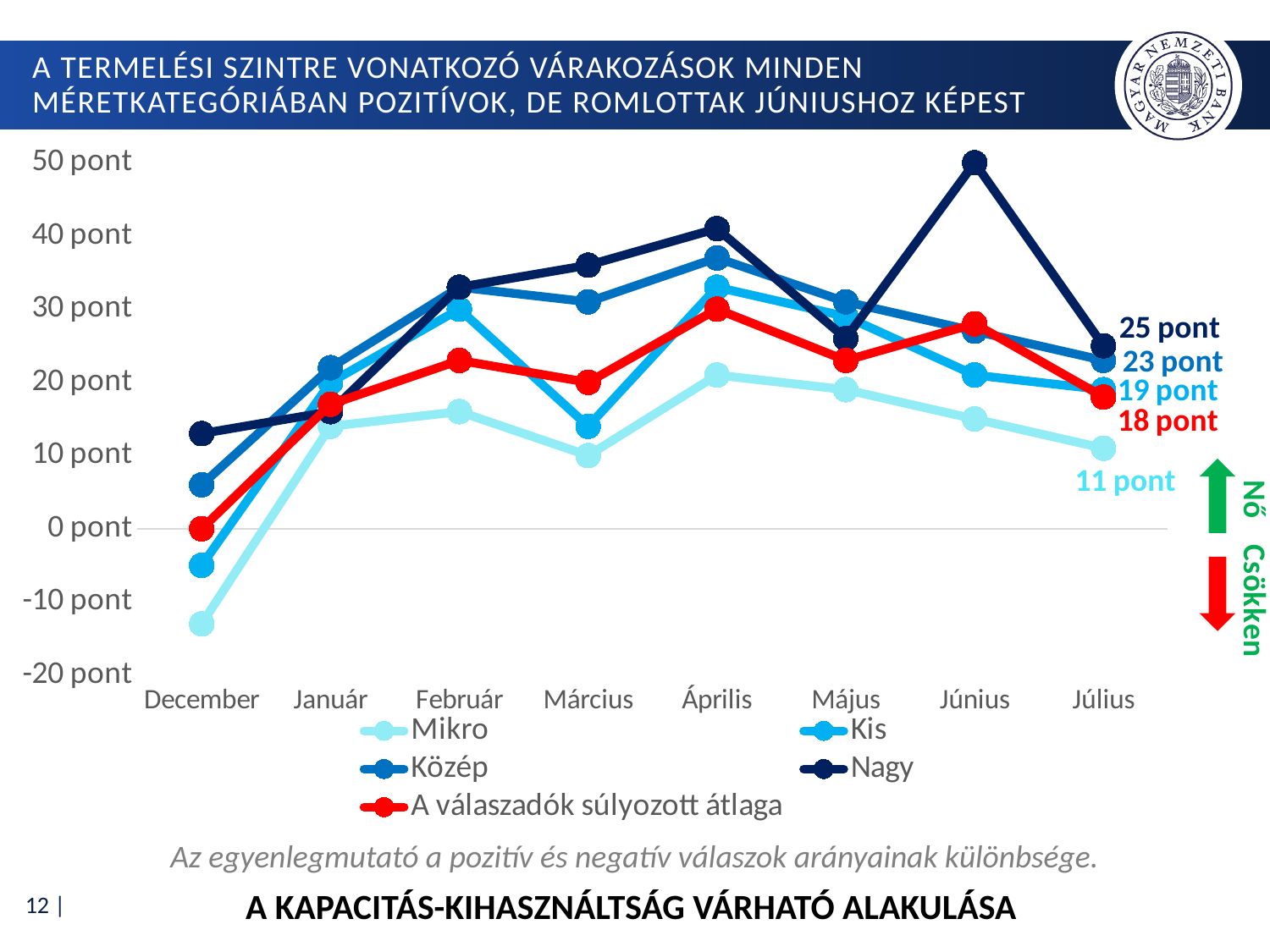
Is the value for Mikro in December greater or less than -10 pont? less What kind of chart is shown on the slide? line chart How many series does the legend list? 5 What is the value for Nagy in Július? 25 pont What is the value for Közép in Július? 23 pont What is the difference between the Nagy and Mikro values in Július? 14 pont Which series has the lowest value in Július? Mikro Which series has the highest value in Július? Nagy How many months are shown on the x axis? 8 What is the value for Mikro in Július? 11 pont Is the value for Nagy in Június greater or less than 40 pont? greater What is the value for A válaszadók súlyozott átlaga in Július? 18 pont